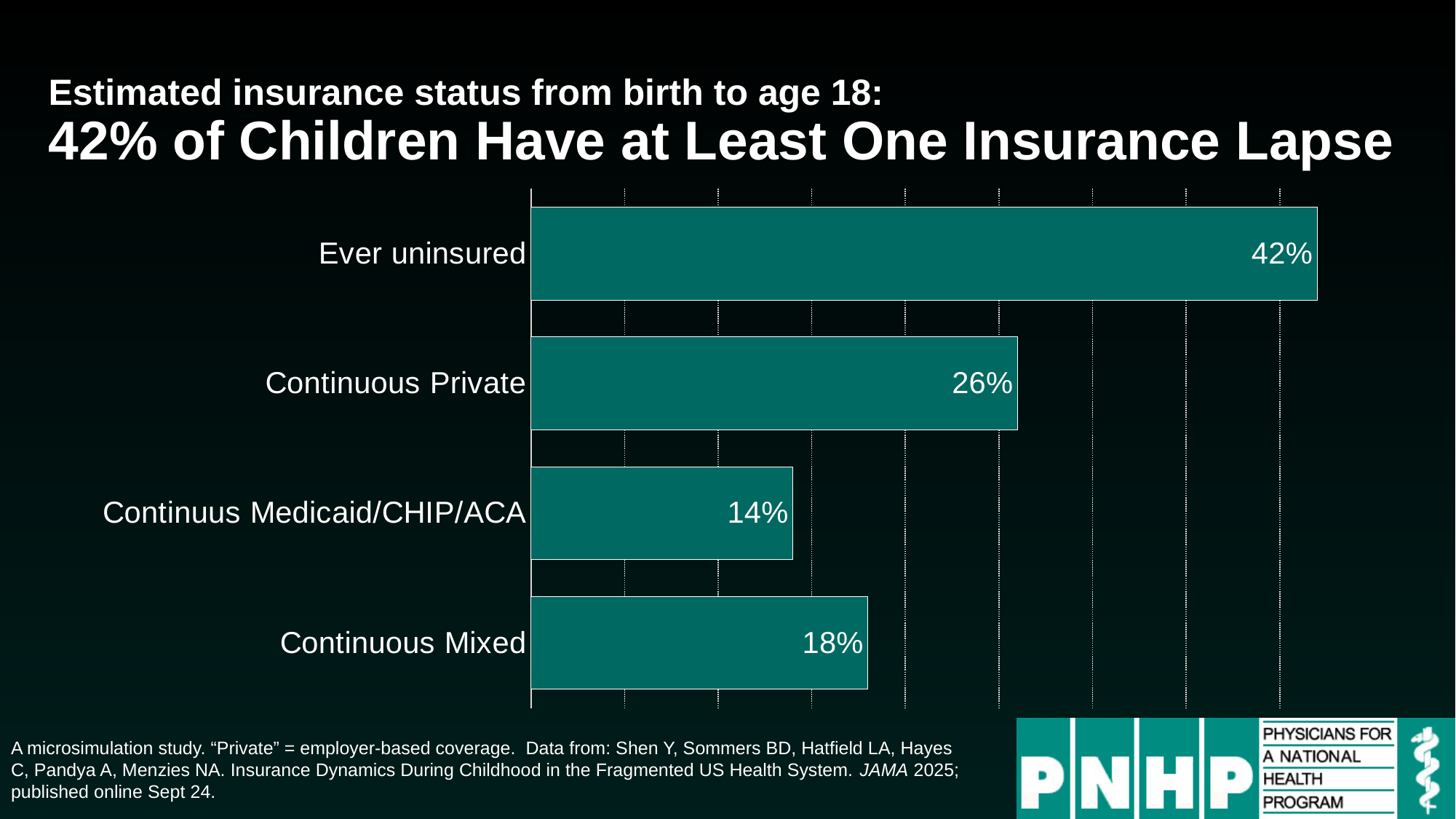
Which is larger, the value for Continuous Private or the value for Continuous Mixed? Continuous Private What is the difference between the values for Ever uninsured and Continuous Private? 16% What is the title of the slide? Estimated insurance status from birth to age 18: 42% of Children Have at Least One Insurance Lapse What is the difference between the values for Continuous Mixed and Continuus Medicaid/CHIP/ACA? 4% How many categories are shown in the chart? 4 What kind of chart is shown on the slide? Bar chart What is the value for Continuous Private? 26% Which category has the highest value? Ever uninsured What is the value for Ever uninsured? 42% Which category has the lowest value? Continuus Medicaid/CHIP/ACA What is the value for Continuus Medicaid/CHIP/ACA? 14% What is the value for Continuous Mixed? 18%